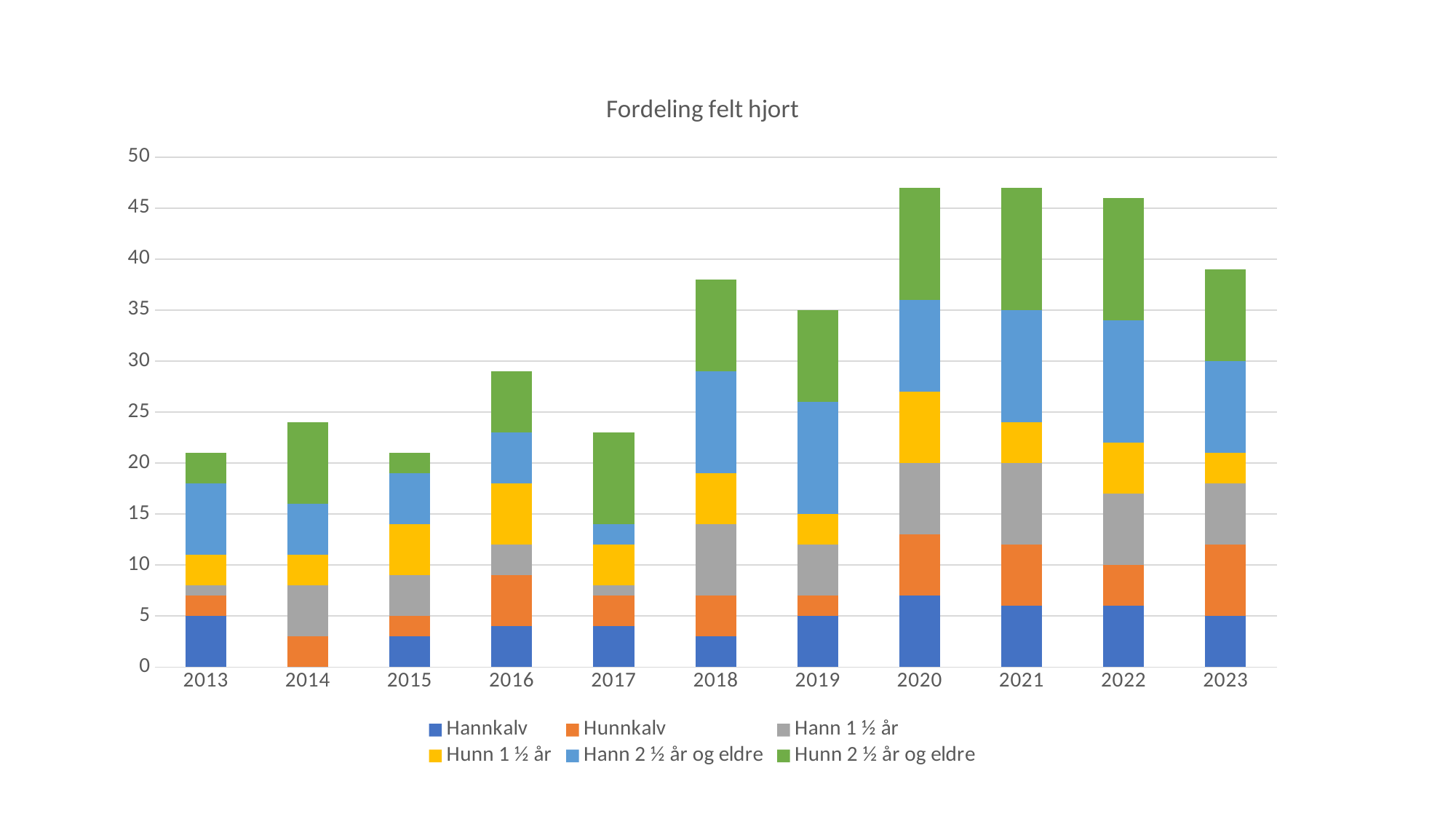
Is the total height of the bar for 2016 greater or less than 25? greater How many series does the legend list? 6 Is the total height of the bar for 2018 greater or less than 35? greater Is the total height of the bar for 2017 greater or less than 25? less Do the total bar heights rise or fall from 2017 to 2020? rise How many years are shown on the x axis of the chart? 11 What kind of chart is shown on the slide? Stacked bar chart Which colour represents the Hannkalv series in the chart? Blue Which year has the taller total bar, 2013 or 2016? 2016 Which year has the taller total bar, 2017 or 2018? 2018 What is the title of the chart? Fordeling felt hjort